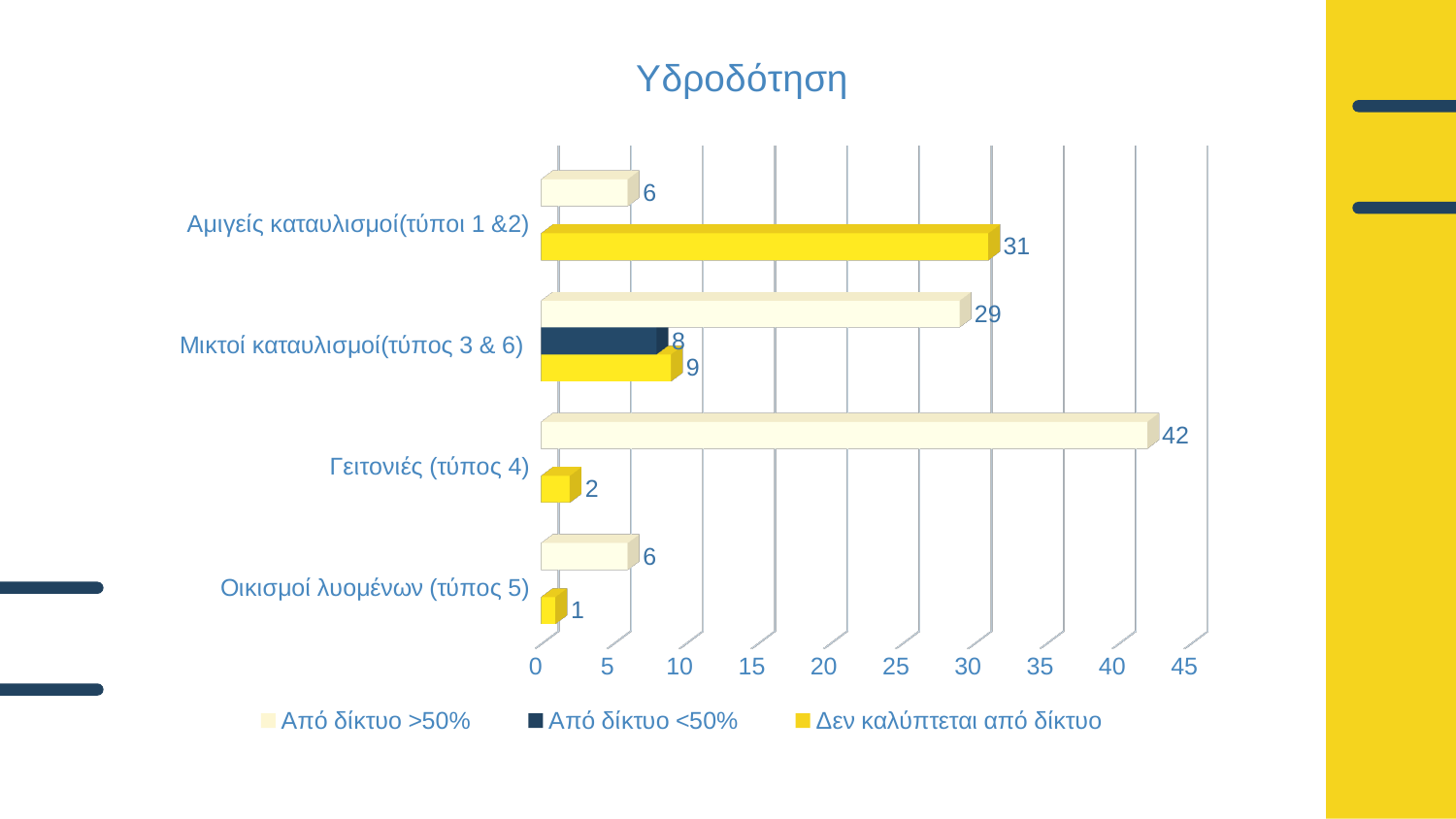
What type of chart is shown on the slide? Bar chart What is the value of 'Από δίκτυο <50%' for Μικτοί καταυλισμοί(τύπος 3 & 6)? 8 How many series does the legend list? 3 What is the value of 'Δεν καλύπτεται από δίκτυο' for Αμιγείς καταυλισμοί(τύποι 1 &2)? 31 Which category is the only one with a bar for 'Από δίκτυο <50%'? Μικτοί καταυλισμοί(τύπος 3 & 6) For Αμιγείς καταυλισμοί(τύποι 1 &2), which is larger: 'Από δίκτυο >50%' or 'Δεν καλύπτεται από δίκτυο'? Δεν καλύπτεται από δίκτυο What is the difference between 'Από δίκτυο >50%' and 'Δεν καλύπτεται από δίκτυο' for Μικτοί καταυλισμοί(τύπος 3 & 6)? 20 Which category has the lowest value for 'Δεν καλύπτεται από δίκτυο'? Οικισμοί λυομένων (τύπος 5) What is the title of the chart? Υδροδότηση Which category has the highest value for 'Από δίκτυο >50%'? Γειτονιές (τύπος 4) How many categories are shown on the vertical axis? 4 What is the value of 'Από δίκτυο >50%' for Γειτονιές (τύπος 4)? 42